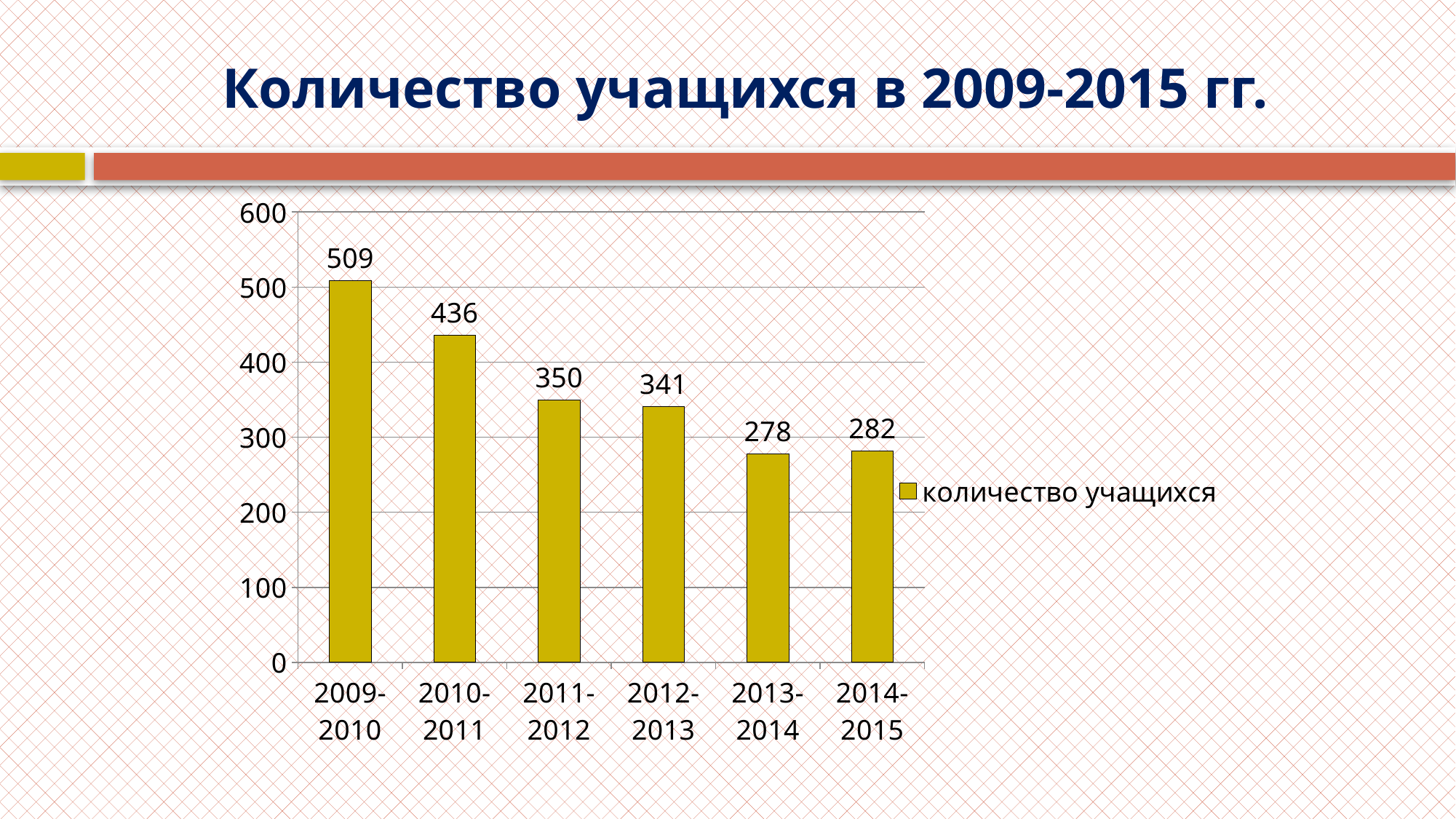
What is the difference between the number of students in 2009-2010 and 2010-2011? 73 Is the value for 2013-2014 greater or less than 300? less Which is larger, the value for 2010-2011 or the value for 2011-2012? 2010-2011 What is the number of students for 2009-2010? 509 What is the number of students for 2012-2013? 341 What kind of chart is shown on the slide? bar chart What is the title of the slide? Количество учащихся в 2009-2015 гг. Which school year has the highest number of students? 2009-2010 How many school years are shown on the x axis? 6 What is the number of students for 2014-2015? 282 What is the difference between the number of students in 2011-2012 and 2013-2014? 72 Which school year has the lowest number of students? 2013-2014